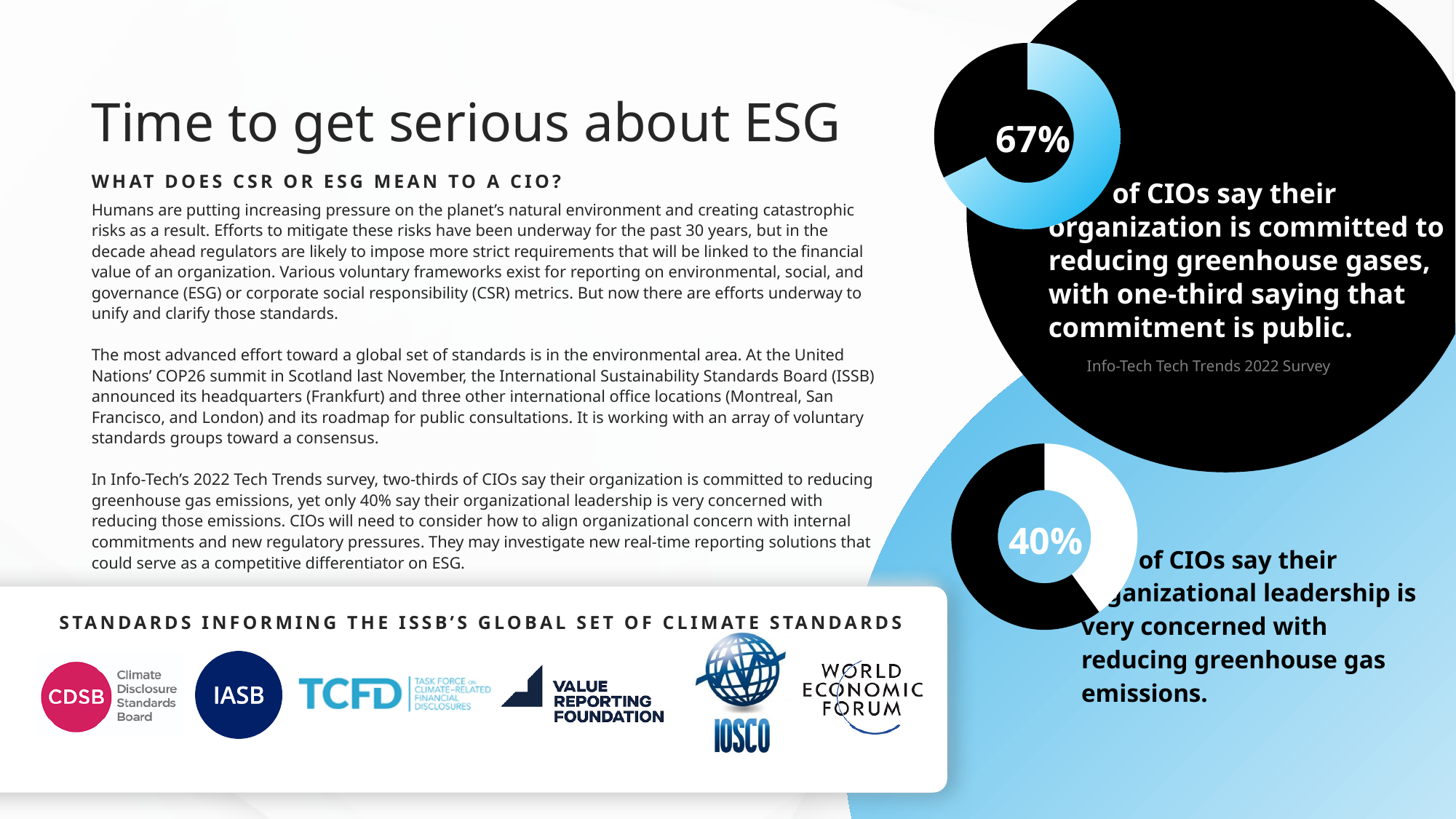
What kind of chart is shown in the top-right black circle on the slide? Donut (pie) chart What share of the top-right donut chart is filled by the highlighted blue slice? 67% In the lower-right chart, what percentage of CIOs say their organizational leadership is very concerned with reducing greenhouse gas emissions? 40% What colour is the highlighted slice in the top-right donut chart? Blue What is the difference in percentage points between the 67% in the top-right chart and the 40% in the lower-right chart? 27 percentage points How many donut charts are shown on the slide? 2 Which is larger: the value in the top-right chart (committed to reducing greenhouse gases) or the value in the lower-right chart (leadership very concerned)? The top-right chart (67%) In the top-right chart, what percentage of CIOs say their organization is committed to reducing greenhouse gases? 67% What share of the lower-right donut chart is filled by the highlighted black slice? 60% What kind of chart is shown in the lower-right blue area of the slide? Donut (pie) chart What survey is cited as the source for the top-right chart? Info-Tech Tech Trends 2022 Survey